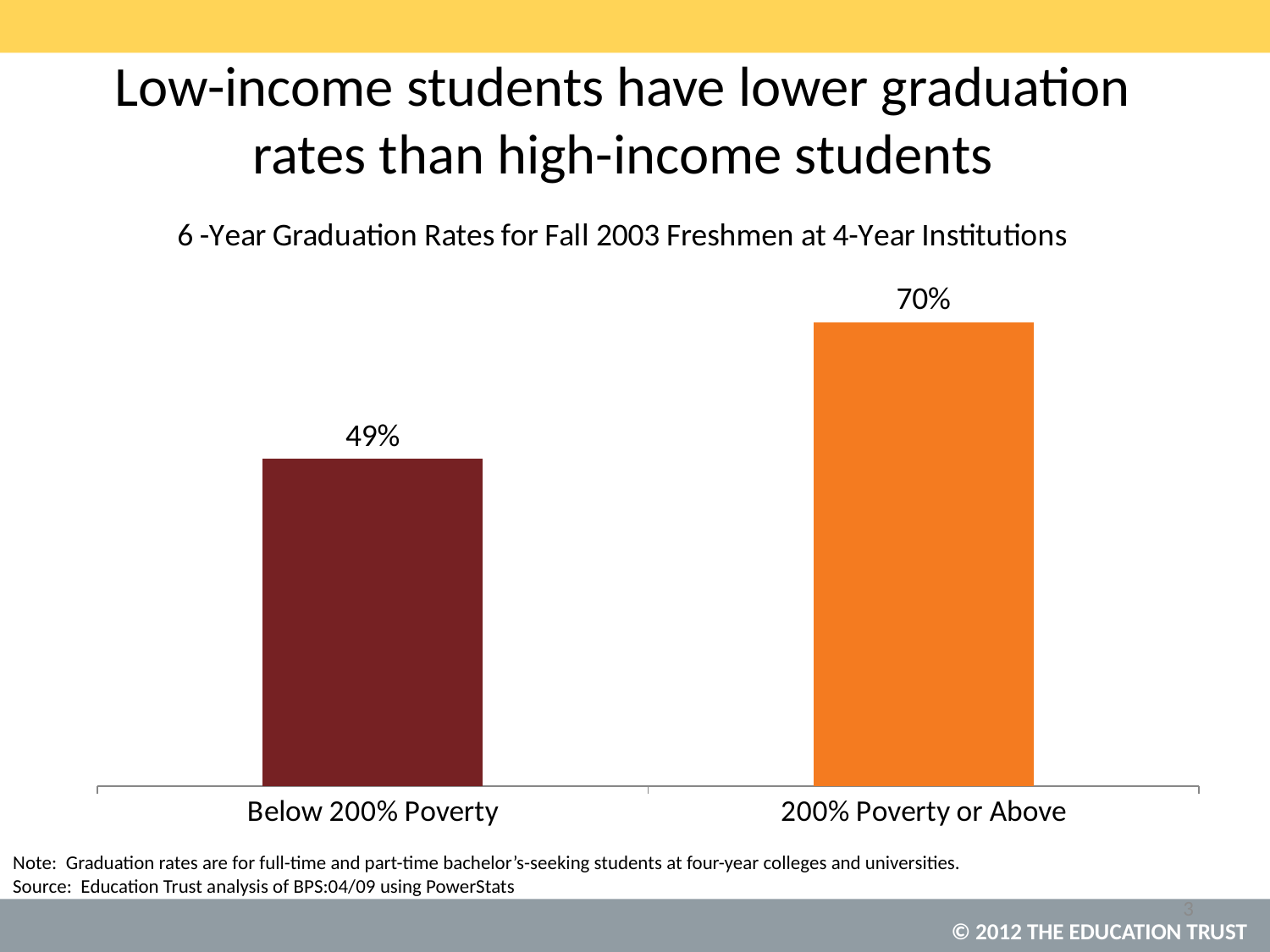
Which category has the higher graduation rate? 200% Poverty or Above What colour is the bar for 200% Poverty or Above? Orange What is the 6-year graduation rate for students Below 200% Poverty? 49% Is the graduation rate higher for Below 200% Poverty or for 200% Poverty or Above? 200% Poverty or Above How many categories are shown in the chart? 2 Which category has the lower graduation rate? Below 200% Poverty What type of chart is shown on the slide? Bar chart What is the difference in graduation rate between 200% Poverty or Above and Below 200% Poverty? 21 percentage points What is the title of the chart? 6 -Year Graduation Rates for Fall 2003 Freshmen at 4-Year Institutions What is the 6-year graduation rate for students at 200% Poverty or Above? 70%